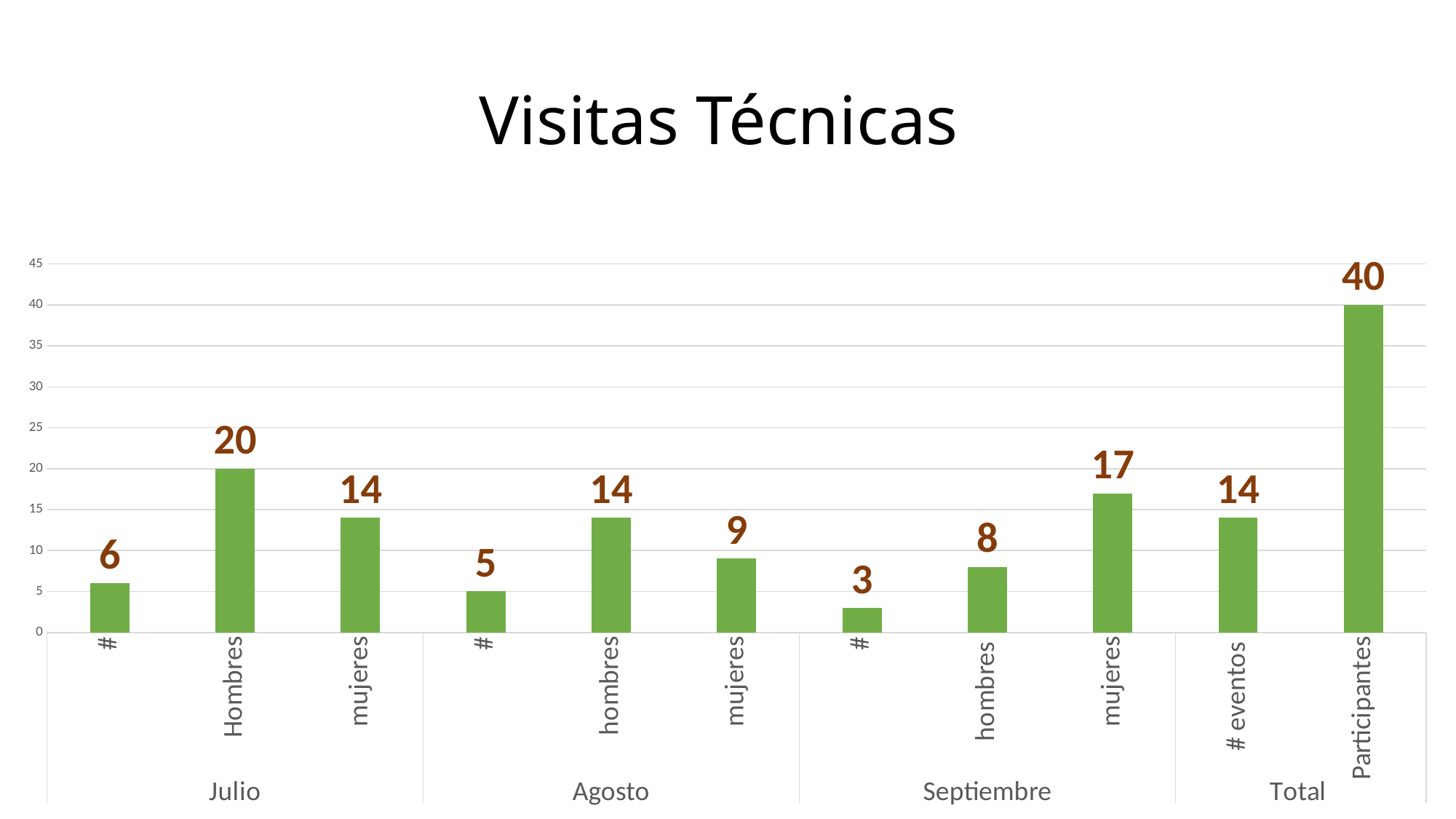
What is the difference between mujeres in Septiembre and hombres in Septiembre? 9 What is the value for Participantes in Total? 40 How many bars are plotted in the chart? 11 Which bar has the lowest value? # (Septiembre) Which is larger, Hombres in Julio or hombres in Agosto? Hombres in Julio What kind of chart is shown? Bar chart What is the value for # eventos in Total? 14 What is the value for mujeres in Agosto? 9 What is the value for # in Septiembre? 3 What is the title of the slide? Visitas Técnicas Which bar has the highest value? Participantes (Total) What is the value for Hombres in Julio? 20